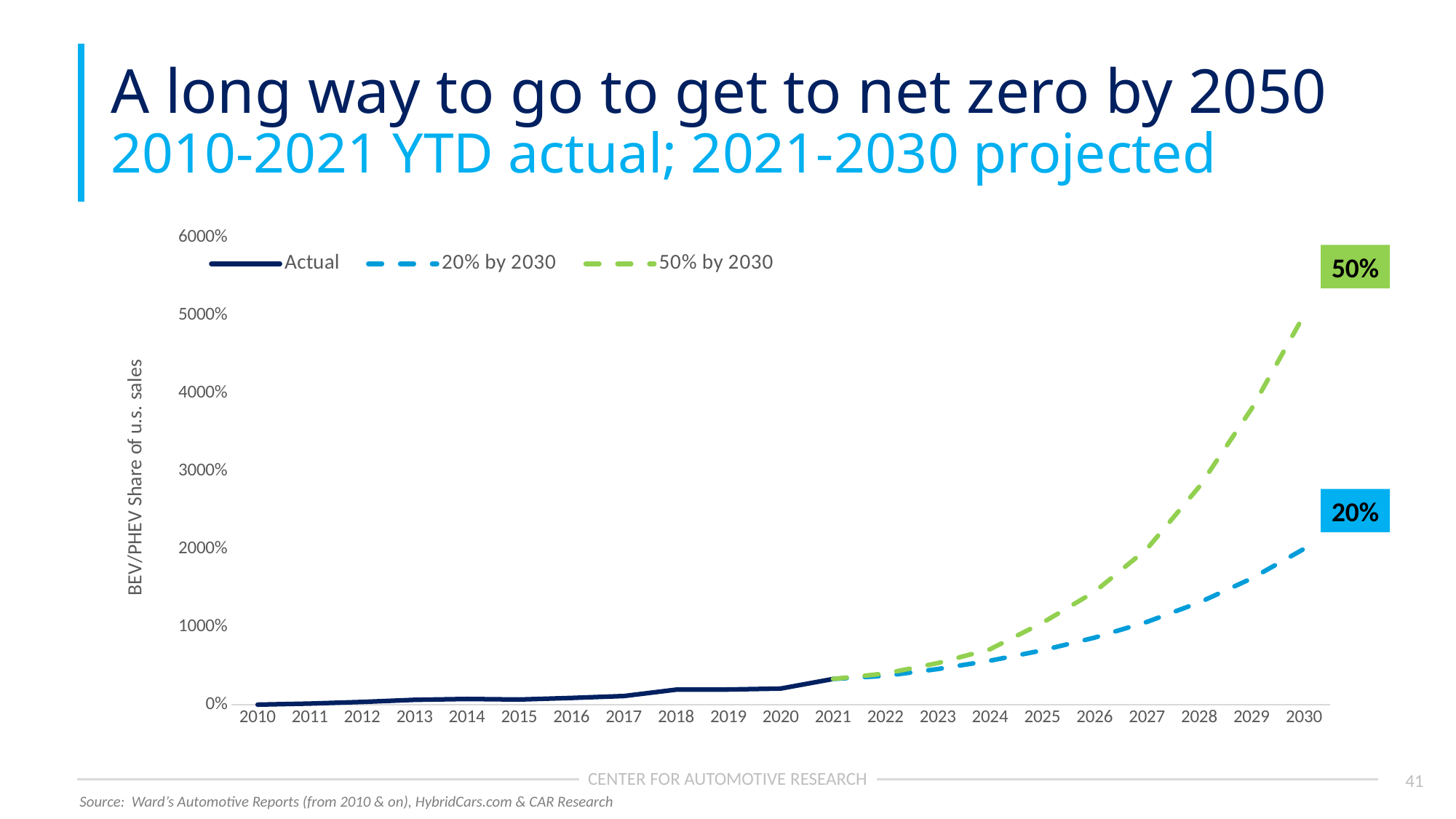
Is the value of the 20% by 2030 series in 2030 greater or less than 3000%? less How many years are shown along the x axis? 21 Does the Actual series rise or fall from 2010 to 2021? rise Is the value of the 50% by 2030 series in 2030 greater or less than 4000%? greater Is the value of the Actual series in 2021 greater or less than 1000%? less What are the three series named in the legend? Actual, 20% by 2030, 50% by 2030 How many series does the legend list? 3 What is the label on the y axis? BEV/PHEV Share of u.s. sales In which year does the 50% by 2030 series reach its highest value? 2030 In 2030, which series has the higher value: 20% by 2030 or 50% by 2030? 50% by 2030 What kind of chart is shown on the slide? line chart